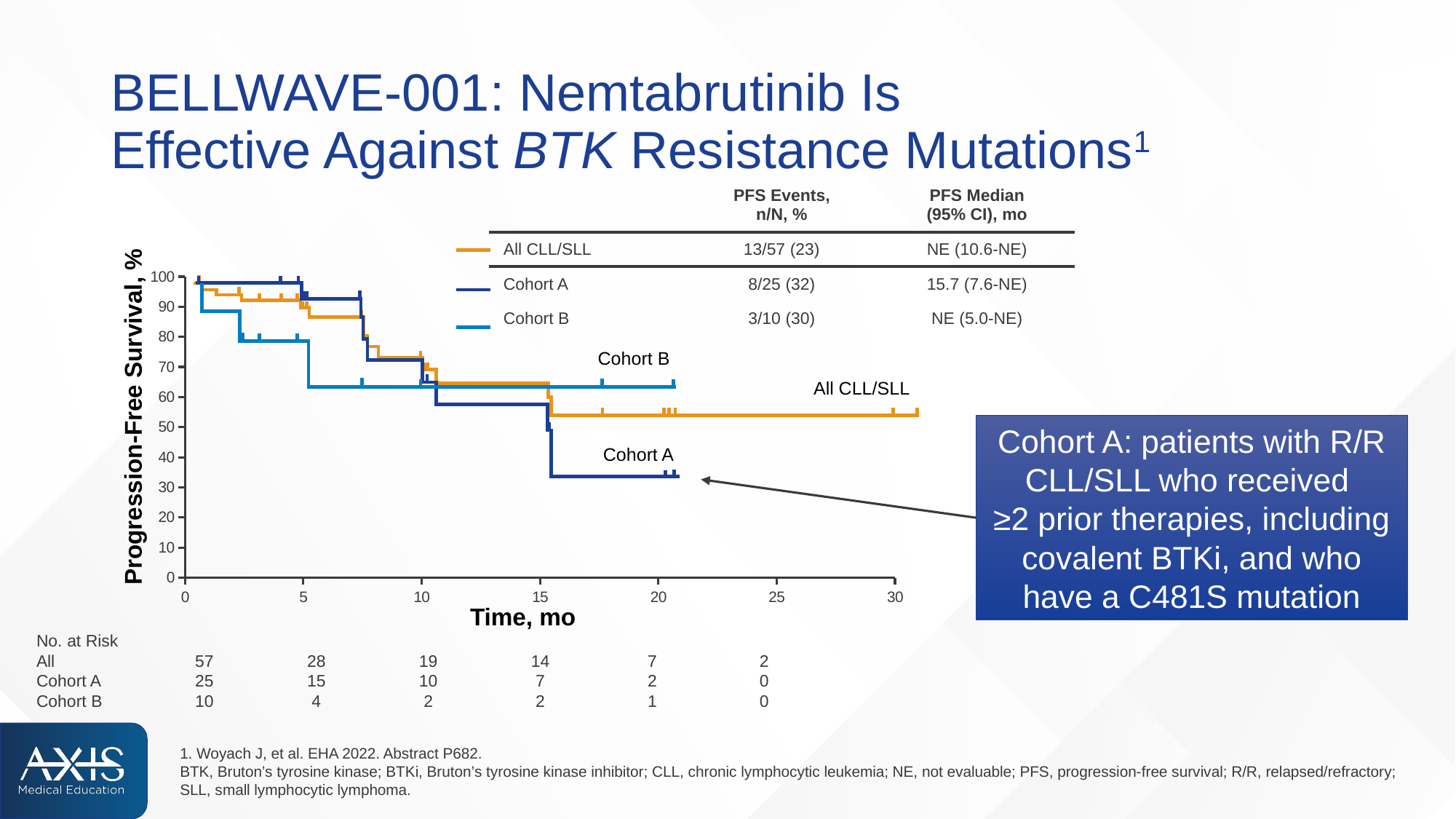
Is the progression-free survival for Cohort A at 20 months greater or less than 40%? less What kind of chart is shown on the slide? Line chart (Kaplan-Meier survival curve) Which group has the lowest progression-free survival at 20 months? Cohort A At 20 months, which curve is higher: Cohort A or Cohort B? Cohort B According to the table on the chart, what is the PFS events n/N (%) for Cohort A? 8/25 (32) How many series (groups) are plotted in the progression-free survival chart? 3 Is the progression-free survival for All CLL/SLL at 30 months greater or less than 50%? greater Do the progression-free survival curves rise or fall as time increases? fall What is the label of the x axis of the chart? Time, mo Is the progression-free survival for Cohort B at 20 months greater or less than 60%? greater What is the label of the y axis of the chart? Progression-Free Survival, % According to the table on the chart, what is the PFS median (95% CI) in months for Cohort A? 15.7 (7.6-NE)